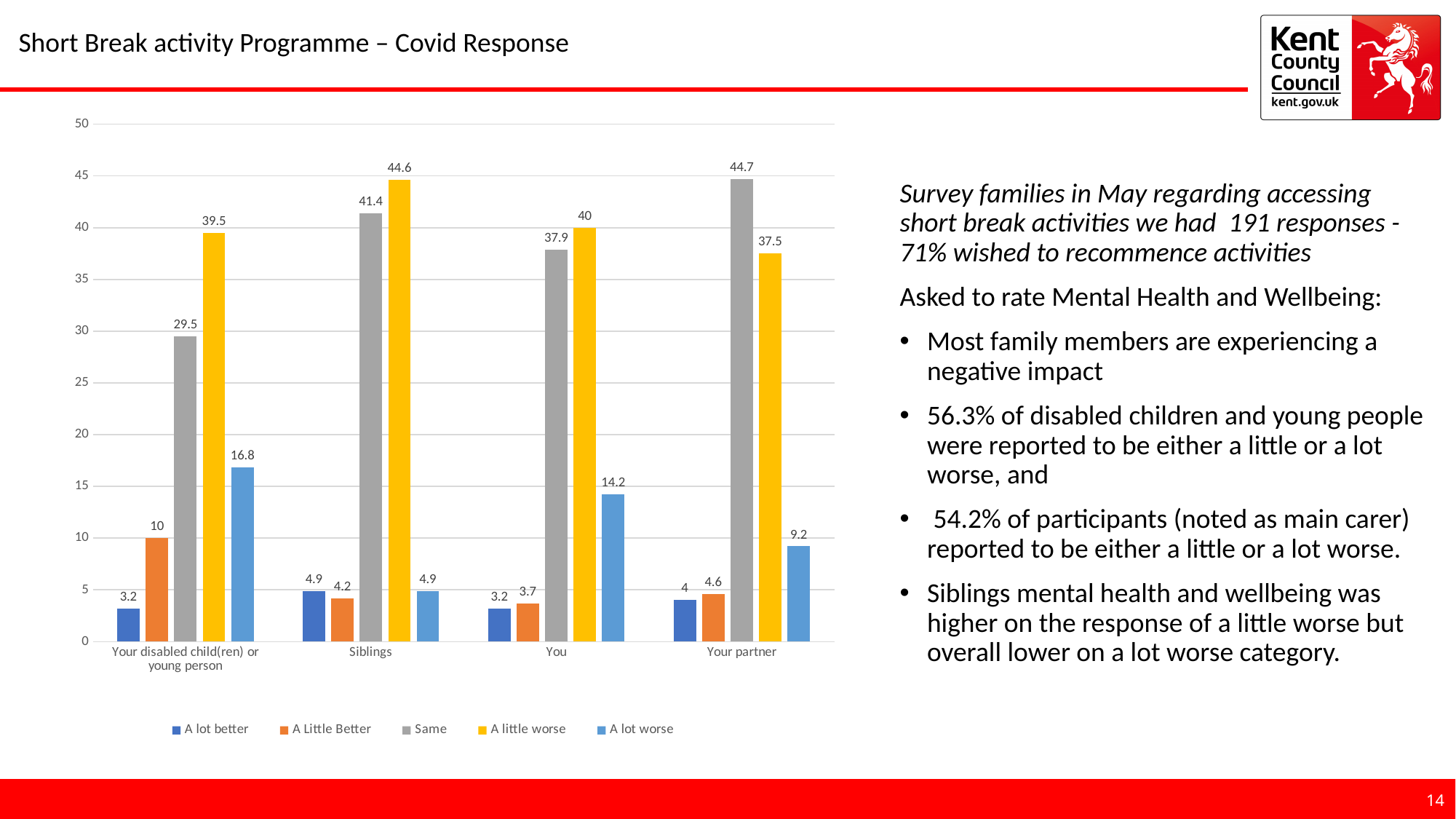
Which category has the highest value for 'A lot worse'? Your disabled child(ren) or young person Which category has the lowest value for 'Same'? Your disabled child(ren) or young person How many categories are shown on the x axis? 4 What is the value for 'A lot worse' for Your disabled child(ren) or young person? 16.8 What is the value for 'A little worse' for Siblings? 44.6 What is the difference between the 'A little worse' and 'Same' values for Your disabled child(ren) or young person? 10 Which series is shown in yellow in the legend? A little worse How many series does the legend list? 5 Which is larger for Your partner: 'Same' or 'A little worse'? Same What is the value for 'A Little Better' for You? 3.7 What kind of chart is shown on the slide? bar chart What is the value for 'Same' for Your partner? 44.7